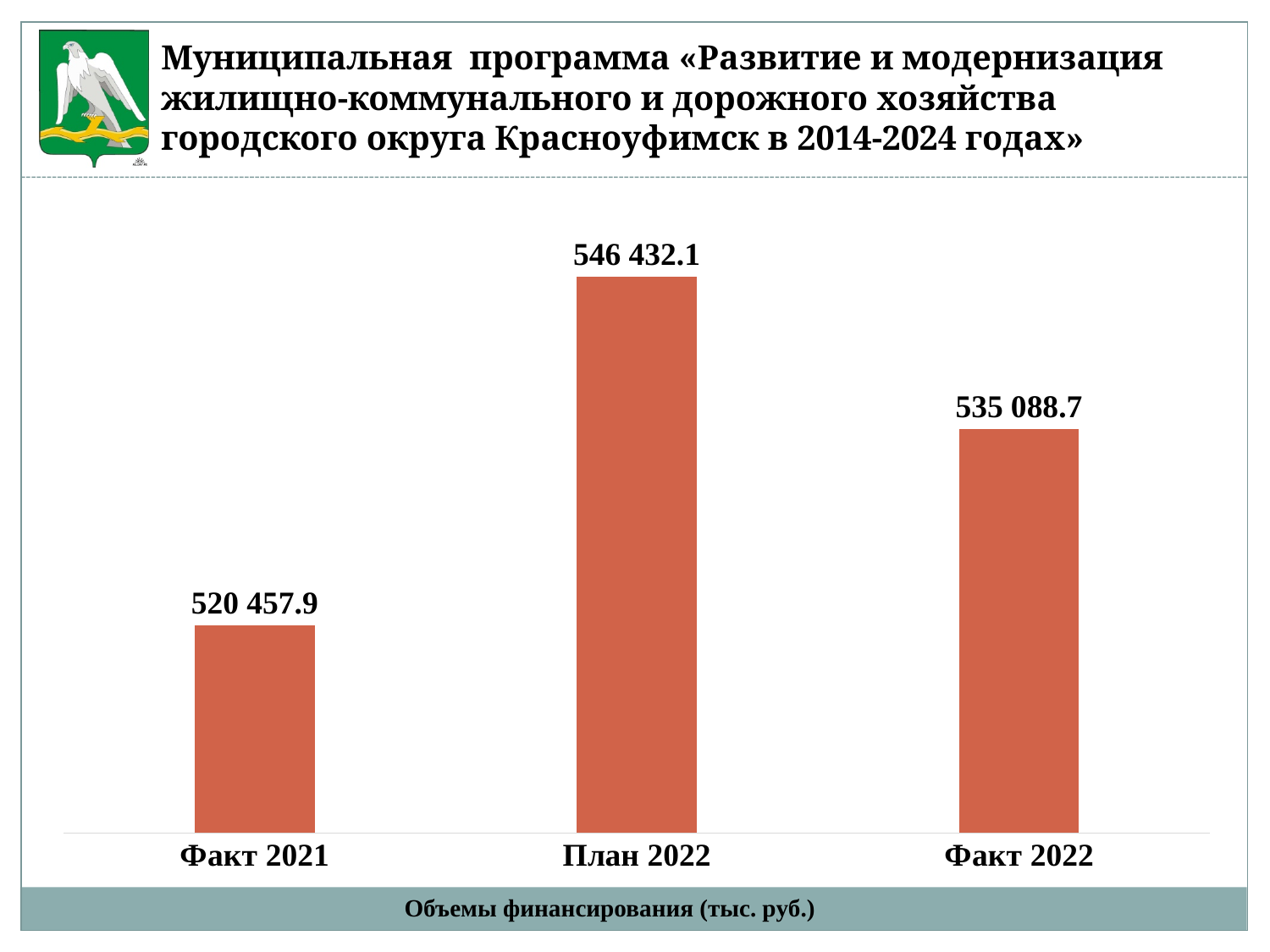
What kind of chart is shown on the slide? Bar chart What is the difference between Факт 2022 and Факт 2021? 14 630.8 Which category has the lowest value? Факт 2021 Do the values rise or fall from План 2022 to Факт 2022? Fall What unit is stated in the caption below the chart? тыс. руб. Which is larger, Факт 2021 or Факт 2022? Факт 2022 How many categories are shown in the chart? 3 What is the difference between План 2022 and Факт 2022? 11 343.4 What is the value for Факт 2021? 520 457.9 Which category has the highest value? План 2022 What is the value for План 2022? 546 432.1 What is the value for Факт 2022? 535 088.7